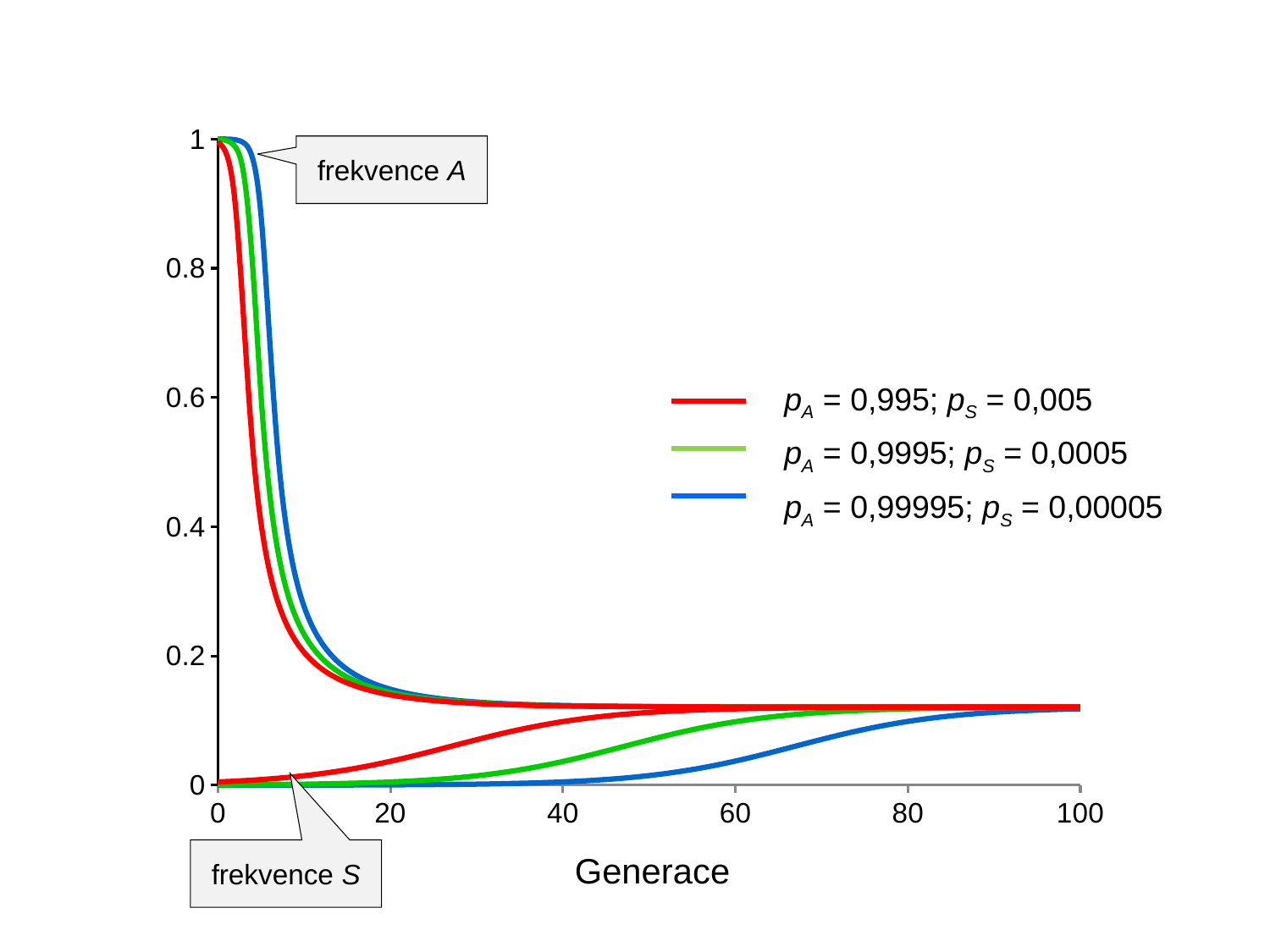
Is the red 'frekvence A' curve at generation 20 greater or less than 0.2? less Do the 'frekvence S' curves rise or fall as the generation number increases? rise Do the 'frekvence A' curves rise or fall as the generation number increases? fall What is the value of 'frekvence A' at generation 0? 1 What is the value of 'frekvence S' at generation 0? 0 At generation 10, which 'frekvence A' curve is higher, the red one or the blue one? blue What is the legend entry for the blue series? p_A = 0,99995; p_S = 0,00005 Is the blue 'frekvence S' curve at generation 40 greater or less than 0.2? less What kind of chart is shown on the slide? line chart How many series does the legend list? 3 What is the label of the x axis? Generace At generation 60, which 'frekvence S' curve is higher, the red one or the blue one? red